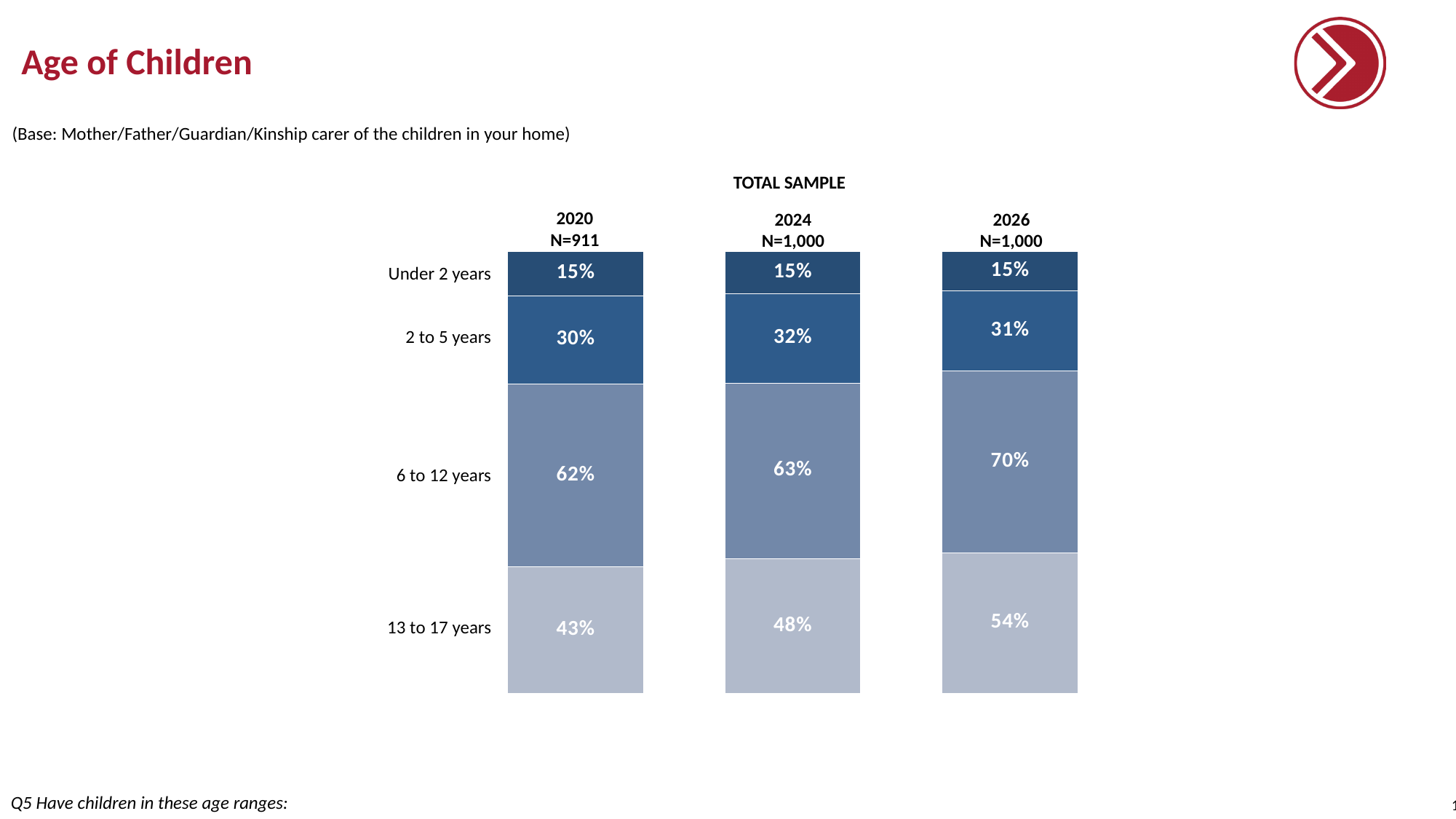
What is the value for Under 2 years in 2026? 15% Does the 13 to 17 years value rise or fall from 2020 to 2026? Rise What is the difference between the 13 to 17 years value in 2026 and in 2020? 11 percentage points What kind of chart is shown on the slide? Stacked bar chart What percentage of the 2024 sample had children aged 2 to 5 years? 32% How many years (bars) are shown in the chart? 3 Which age range has the highest percentage in the 2026 bar? 6 to 12 years Which age range has the lowest percentage in the 2020 bar? Under 2 years What percentage of the 2026 sample had children aged 13 to 17 years? 54% What percentage of the 2020 sample had children aged 6 to 12 years? 62% How many age ranges are shown in each stacked bar? 4 Which is larger: the 6 to 12 years value in 2024 or in 2026? 2026